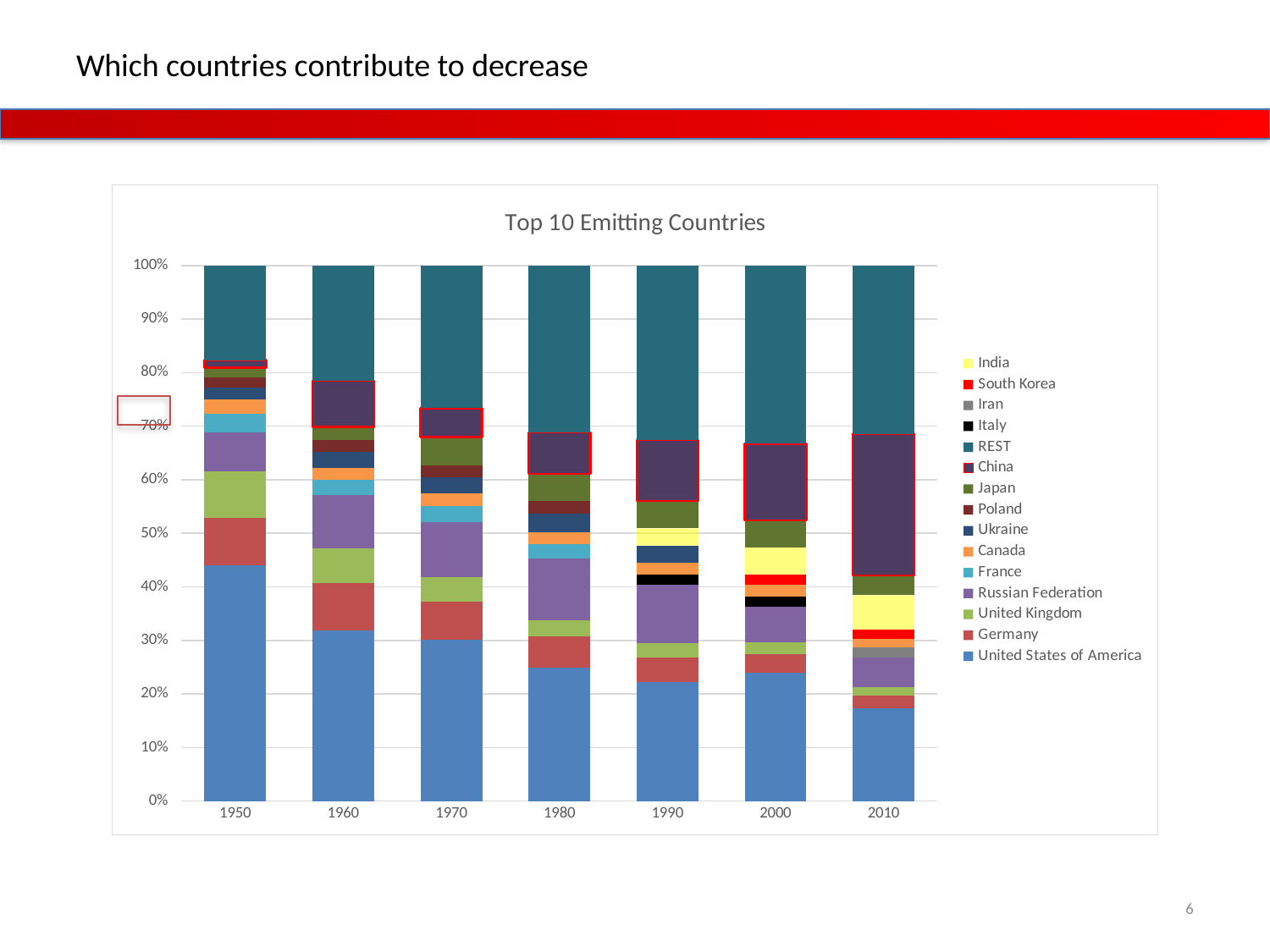
Which series is plotted at the top of each stacked bar? REST What is the title of the chart? Top 10 Emitting Countries Is the share for United States of America in 1990 greater or less than 30%? less Is the share for United States of America in 2010 greater or less than 20%? less How many years (bars) are shown on the x axis of the chart? 7 In which year is the share for United States of America the lowest? 2010 In which year is the share for United States of America the highest? 1950 How many series does the chart legend list? 15 What kind of chart is shown on the slide? Stacked bar chart Is the share for United States of America in 1950 greater or less than 40%? greater Which is larger, the share for United States of America in 1950 or in 2010? 1950 Does the share for United States of America rise or fall from 1950 to 2010? fall